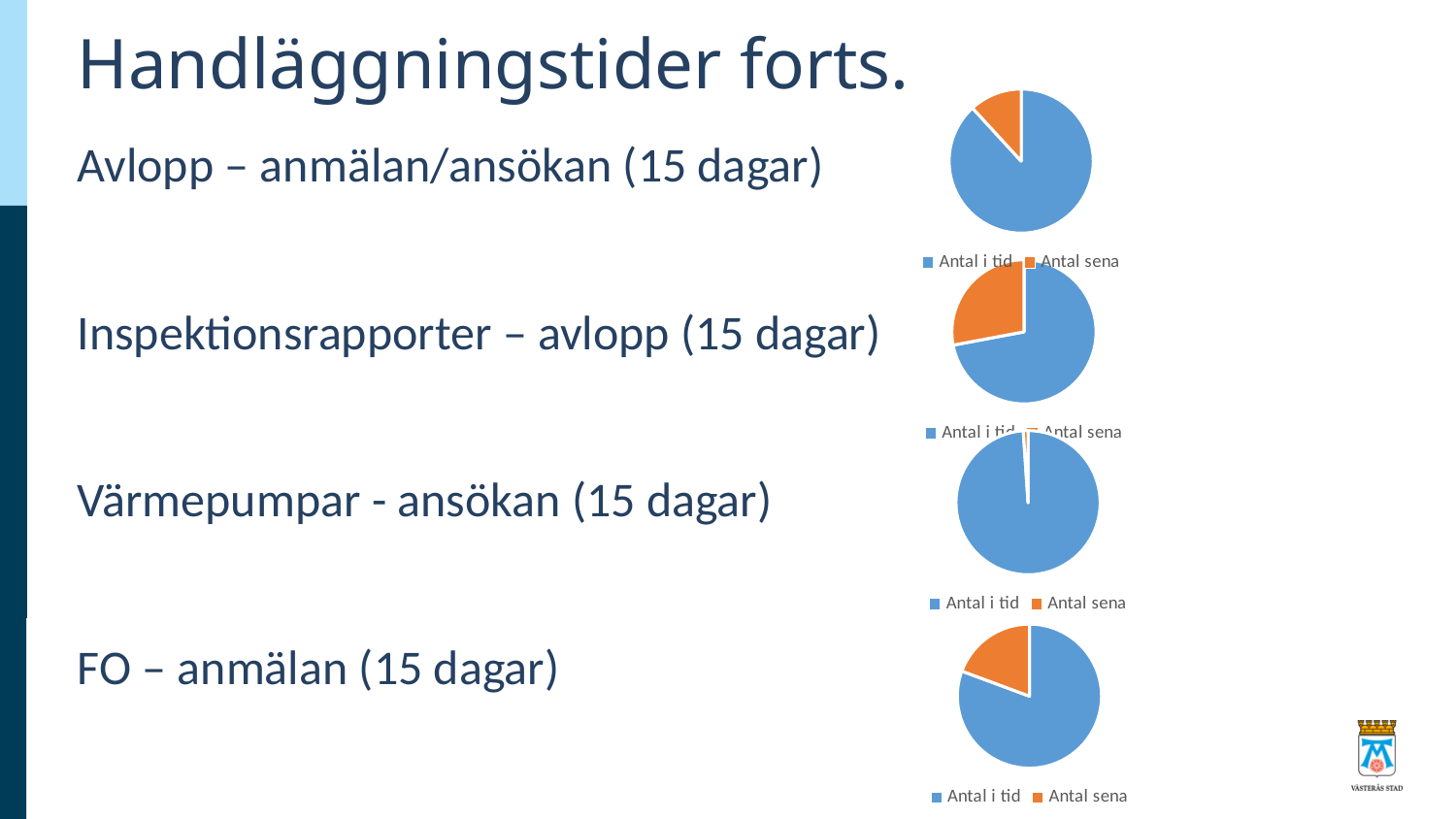
What colour represents 'Antal sena' in the pie charts? orange In the bottom pie chart, which slice is larger, 'Antal i tid' or 'Antal sena'? Antal i tid How many pie charts are shown on the slide? 4 Which of the four pie charts has the smallest 'Antal sena' slice? the third pie chart from the top In the second pie chart from the top, which category has the largest slice? Antal i tid What kind of chart is the top chart on the right side of the slide? pie chart In the top pie chart, which slice is larger, 'Antal i tid' or 'Antal sena'? Antal i tid How many entries does the legend of the top pie chart list? 2 What are the two legend entries shown under the bottom pie chart? Antal i tid, Antal sena Which of the four pie charts has the largest 'Antal sena' slice? the second pie chart from the top How many slices does the bottom pie chart have? 2 In the third pie chart from the top, which category has the smallest slice? Antal sena